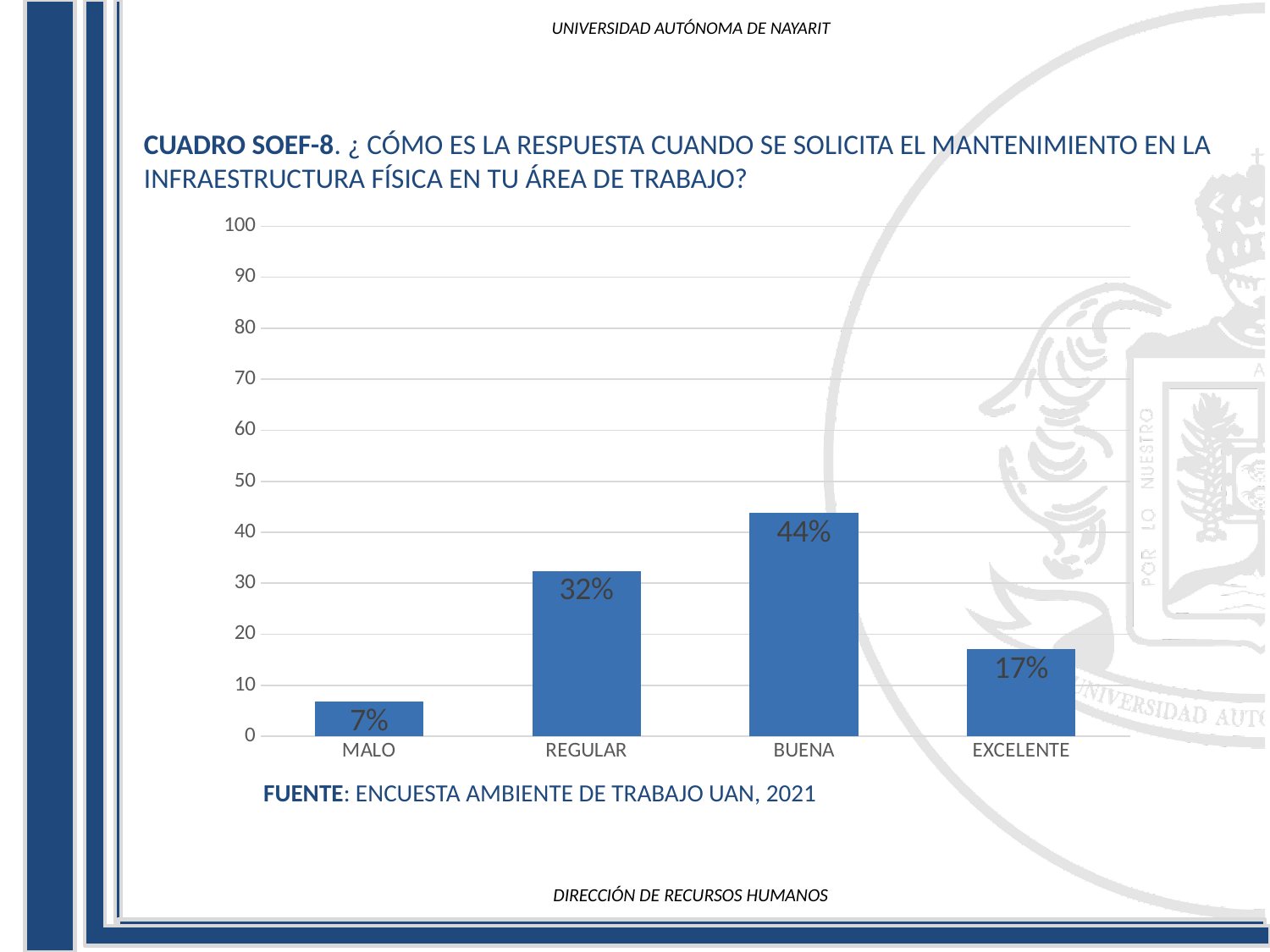
What is the value for MALO? 7% Which is larger, the value for REGULAR or the value for EXCELENTE? REGULAR What is the value for EXCELENTE? 17% What is the difference between the values for BUENA and REGULAR? 12% Which category has the highest value? BUENA What is the highest tick value shown on the vertical axis? 100 What kind of chart is shown on the slide? bar chart Is the value for REGULAR greater or less than 30? greater How many categories are shown on the x axis? 4 What is the value for BUENA? 44% What is the source cited below the chart? ENCUESTA AMBIENTE DE TRABAJO UAN, 2021 Which category has the lowest value? MALO